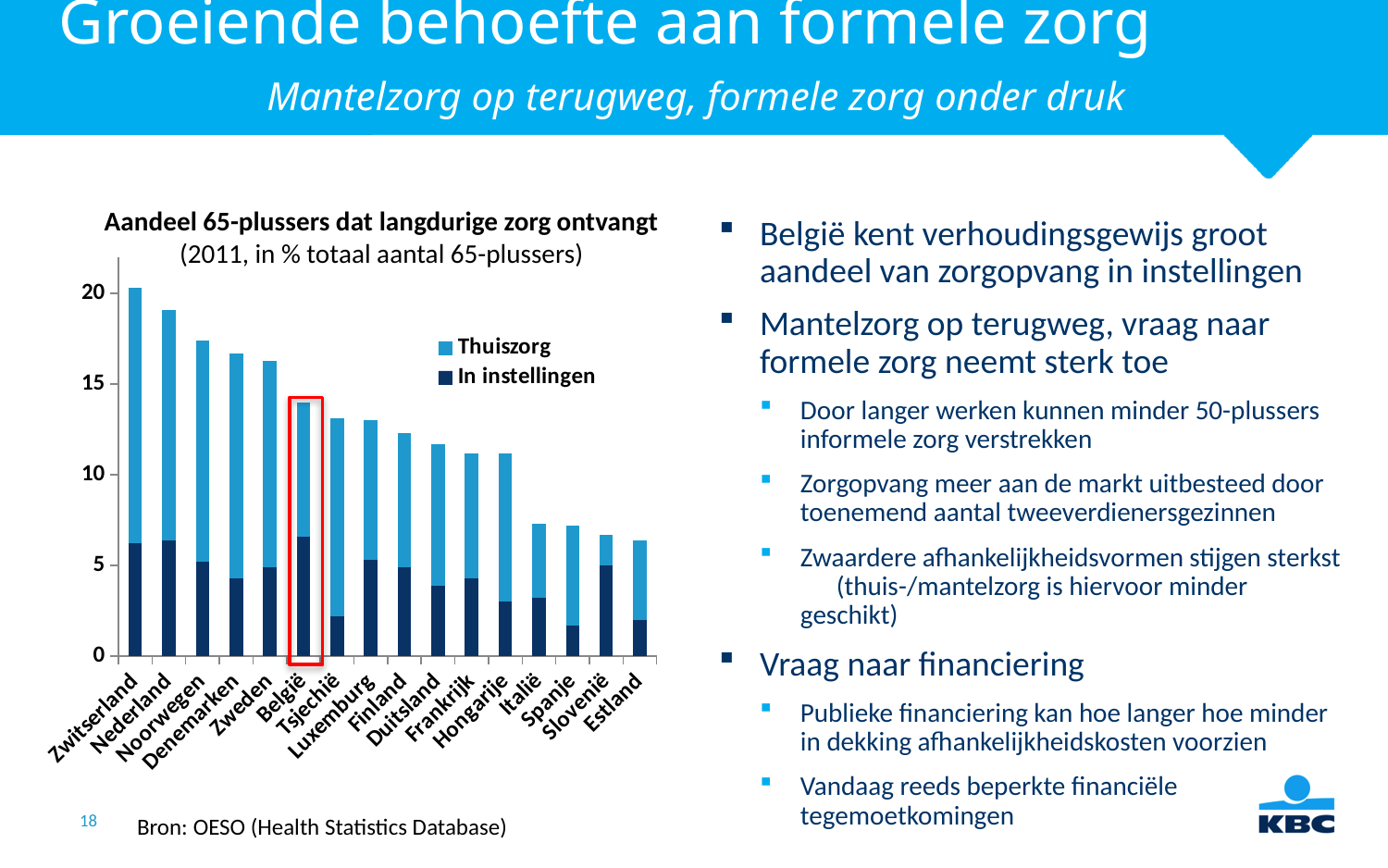
Which country has the highest total share of 65-plussers receiving long-term care? Zwitserland Do the total bar heights rise or fall from left to right along the x axis? Fall Is the total value for Italië greater or less than 10? less Is the total value for Nederland greater or less than 15? greater How many countries are shown on the x axis of the chart? 16 How many series does the chart legend list? 2 Which series is shown in dark blue in the legend? In instellingen Which country's bar is highlighted with a red box? België Is the total value for België greater or less than 10? greater Which has a larger total value, Nederland or Noorwegen? Nederland What kind of chart is shown on the slide? Stacked bar chart